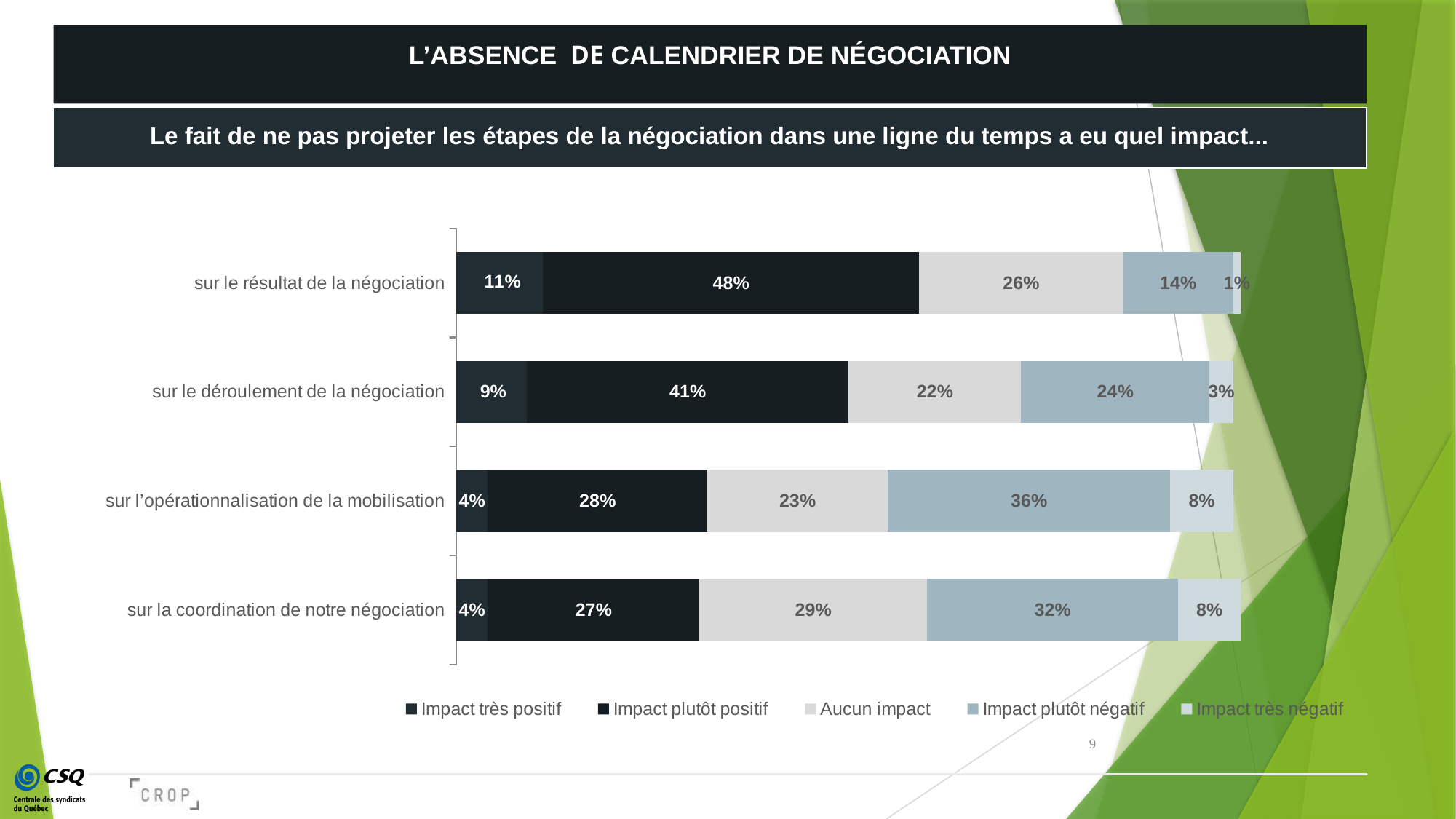
Which category has the lowest value for "Impact très négatif"? sur le résultat de la négociation What kind of chart is shown on the slide? Stacked bar chart What is the value of "Impact plutôt négatif" for "sur l'opérationnalisation de la mobilisation"? 36% How many categories are shown on the chart? 4 What is the total of the stacked bar for "sur le déroulement de la négociation"? 99% What is the difference in "Impact plutôt positif" between "sur le résultat de la négociation" and "sur la coordination de notre négociation"? 21 percentage points What is the value of "Impact très négatif" for "sur le déroulement de la négociation"? 3% How many series does the legend list? 5 What is the value of "Impact plutôt positif" for "sur le résultat de la négociation"? 48% Which category has the highest value for "Impact très positif"? sur le résultat de la négociation What is the value of "Aucun impact" for "sur la coordination de notre négociation"? 29% Which has the larger "Impact plutôt négatif" value: "sur le déroulement de la négociation" or "sur l'opérationnalisation de la mobilisation"? sur l'opérationnalisation de la mobilisation